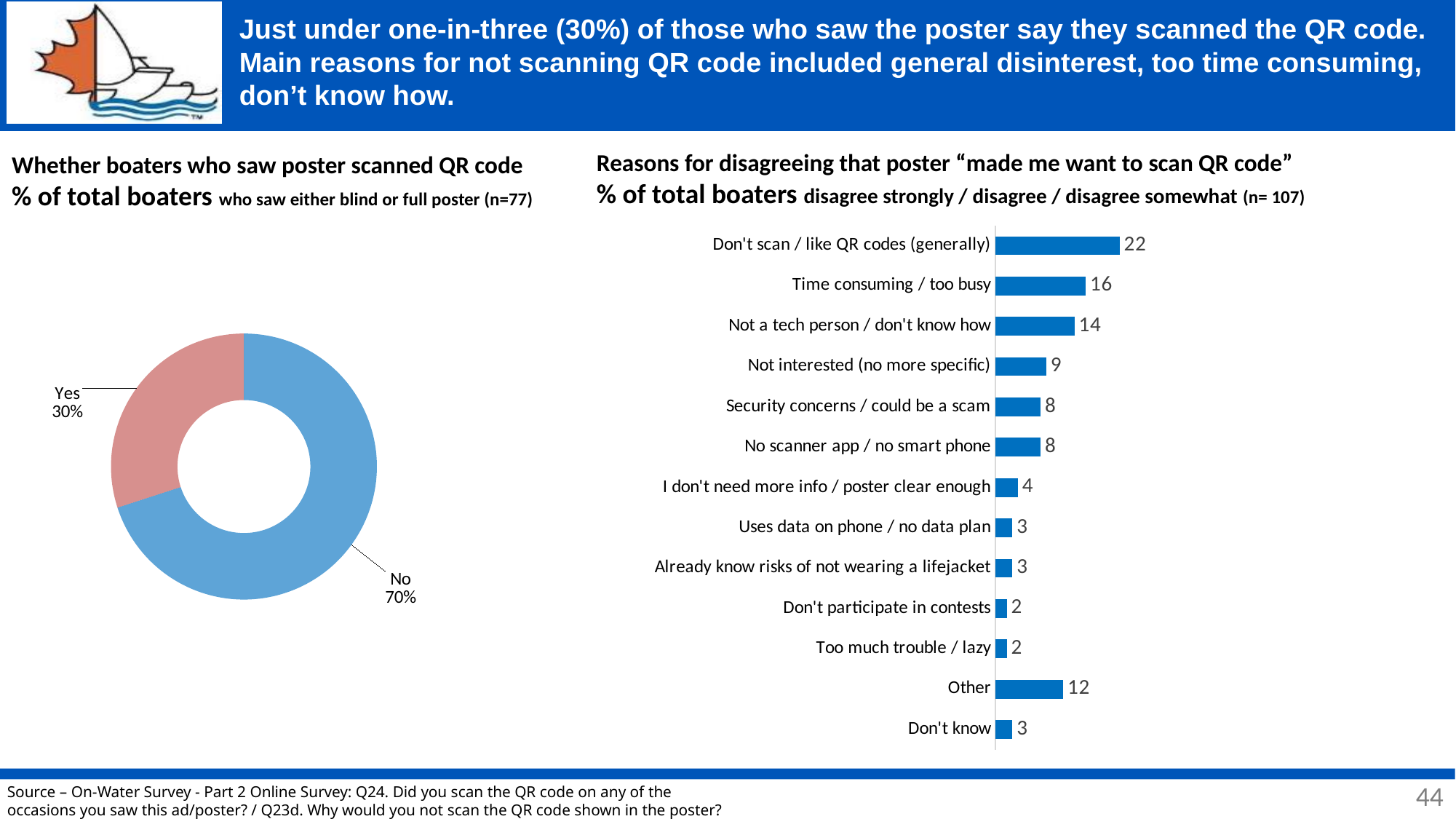
What kind of chart is the 'Whether boaters who saw poster scanned QR code' chart? Doughnut (pie) chart What kind of chart is the 'Reasons for disagreeing that poster made me want to scan QR code' chart? Bar chart In the 'Reasons for disagreeing that poster made me want to scan QR code' chart, what is the value for 'Not a tech person / don't know how'? 14 In the 'Whether boaters who saw poster scanned QR code' chart, what percentage answered Yes? 30% In the 'Reasons for disagreeing that poster made me want to scan QR code' chart, what is the value for 'Don't know'? 3 In the 'Reasons for disagreeing that poster made me want to scan QR code' chart, how many reasons are listed? 13 In the 'Whether boaters who saw poster scanned QR code' chart, how many slices are there? 2 In the 'Whether boaters who saw poster scanned QR code' chart, what percentage answered No? 70% In the 'Reasons for disagreeing that poster made me want to scan QR code' chart, which reason has the highest value? Don't scan / like QR codes (generally) In the 'Reasons for disagreeing that poster made me want to scan QR code' chart, which is larger: 'Other' or 'Security concerns / could be a scam'? Other In the 'Reasons for disagreeing that poster made me want to scan QR code' chart, what is the difference between 'Time consuming / too busy' and 'Not interested (no more specific)'? 7 In the 'Reasons for disagreeing that poster made me want to scan QR code' chart, what is the value for 'Don't scan / like QR codes (generally)'? 22